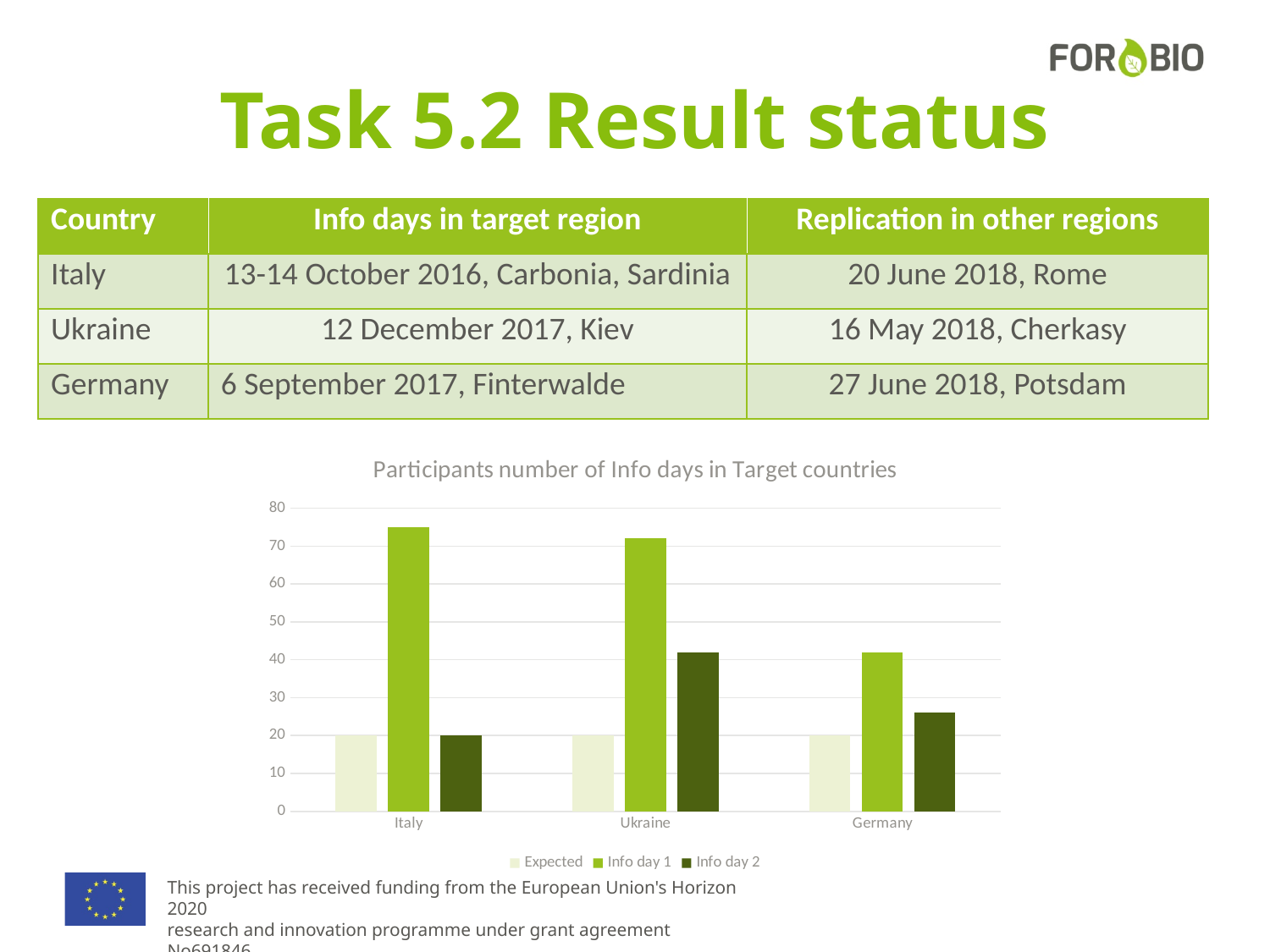
Is the Info day 1 value for Italy greater or less than 70? greater Which country has the lowest Info day 2 value? Italy How many countries are shown on the x axis of the chart? 3 Is the Info day 1 value for Germany greater or less than 50? less Which country has the highest Info day 2 value? Ukraine What is the title of the chart? Participants number of Info days in Target countries What kind of chart is shown on the slide? bar chart Which is larger, the Info day 1 value for Italy or the Info day 1 value for Germany? Italy Is the Info day 2 value for Ukraine greater or less than 30? greater How many series does the chart legend list? 3 What is the Expected value for Italy? 20 What is the Info day 2 value for Italy? 20